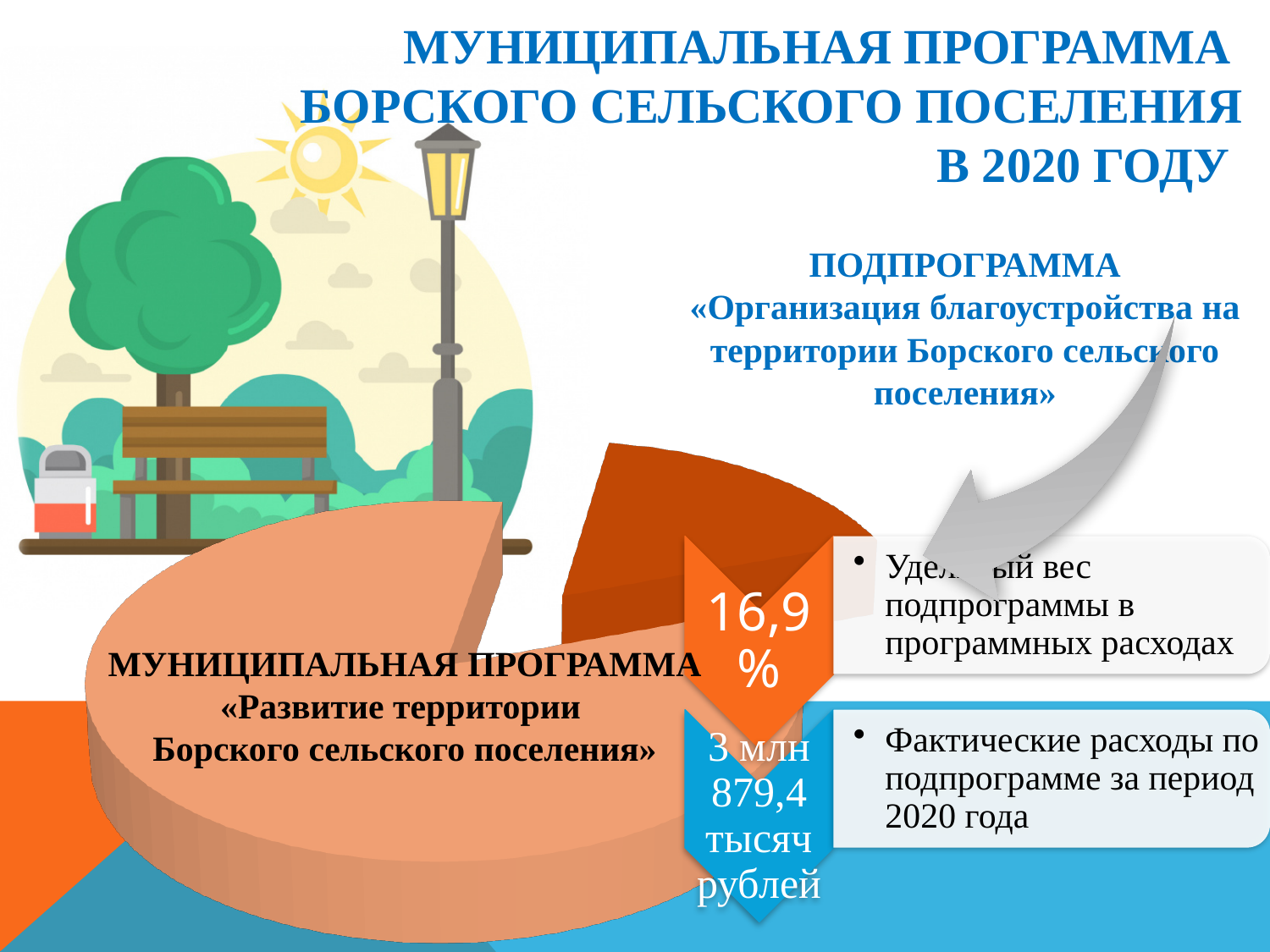
How many slices does the pie chart have? 2 What does the 16,9% figure on the slide represent? Удельный вес подпрограммы в программных расходах Which slice of the pie chart is the smallest? Подпрограмма «Организация благоустройства на территории Борского сельского поселения» What are the actual expenses for the subprogram «Организация благоустройства» for 2020 shown on the slide? 3 млн 879,4 тысяч рублей What share of the pie does the subprogram «Организация благоустройства на территории Борского сельского поселения» represent? 16,9% What colour is the exploded slice representing the subprogram «Организация благоустройства»? orange Which slice of the pie chart is the largest? МУНИЦИПАЛЬНАЯ ПРОГРАММА «Развитие территории Борского сельского поселения» Which is larger in the pie chart: the slice for the municipal program «Развитие территории Борского сельского поселения» or the slice for the subprogram «Организация благоустройства»? the municipal program «Развитие территории Борского сельского поселения» What kind of chart is shown on the slide? pie chart